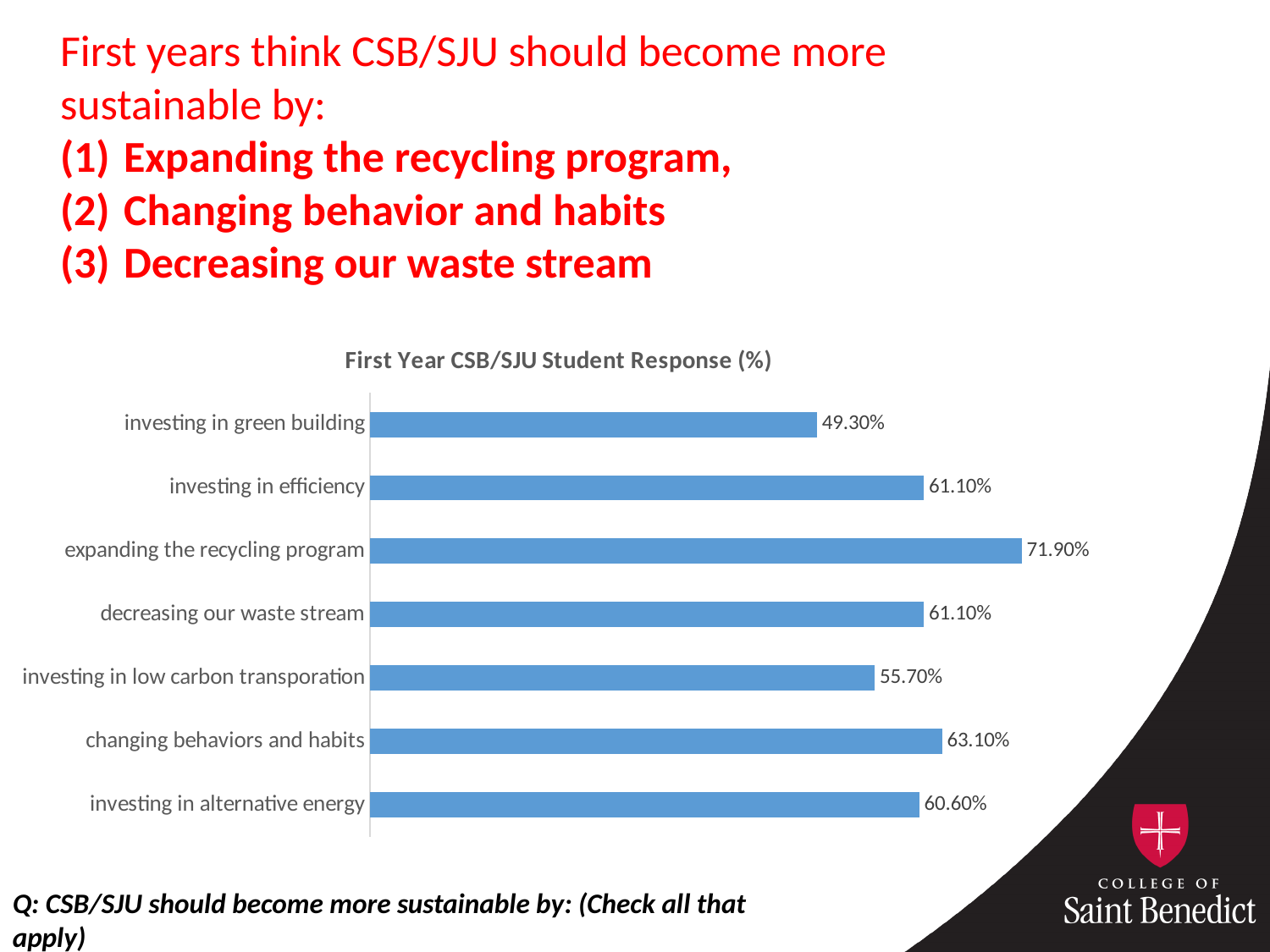
Which category has the highest value? expanding the recycling program What is the difference between 'changing behaviors and habits' and 'investing in alternative energy'? 2.50% What is the value for 'investing in low carbon transporation'? 55.70% What is the value for 'expanding the recycling program'? 71.90% What is the value for 'investing in green building'? 49.30% Which category has the lowest value? investing in green building How many categories are shown in the chart? 7 What is the value for 'changing behaviors and habits'? 63.10% What is the difference between 'expanding the recycling program' and 'investing in green building'? 22.60% What kind of chart is shown on the slide? bar chart Which is larger: 'investing in efficiency' or 'investing in low carbon transporation'? investing in efficiency What is the title of the chart? First Year CSB/SJU Student Response (%)